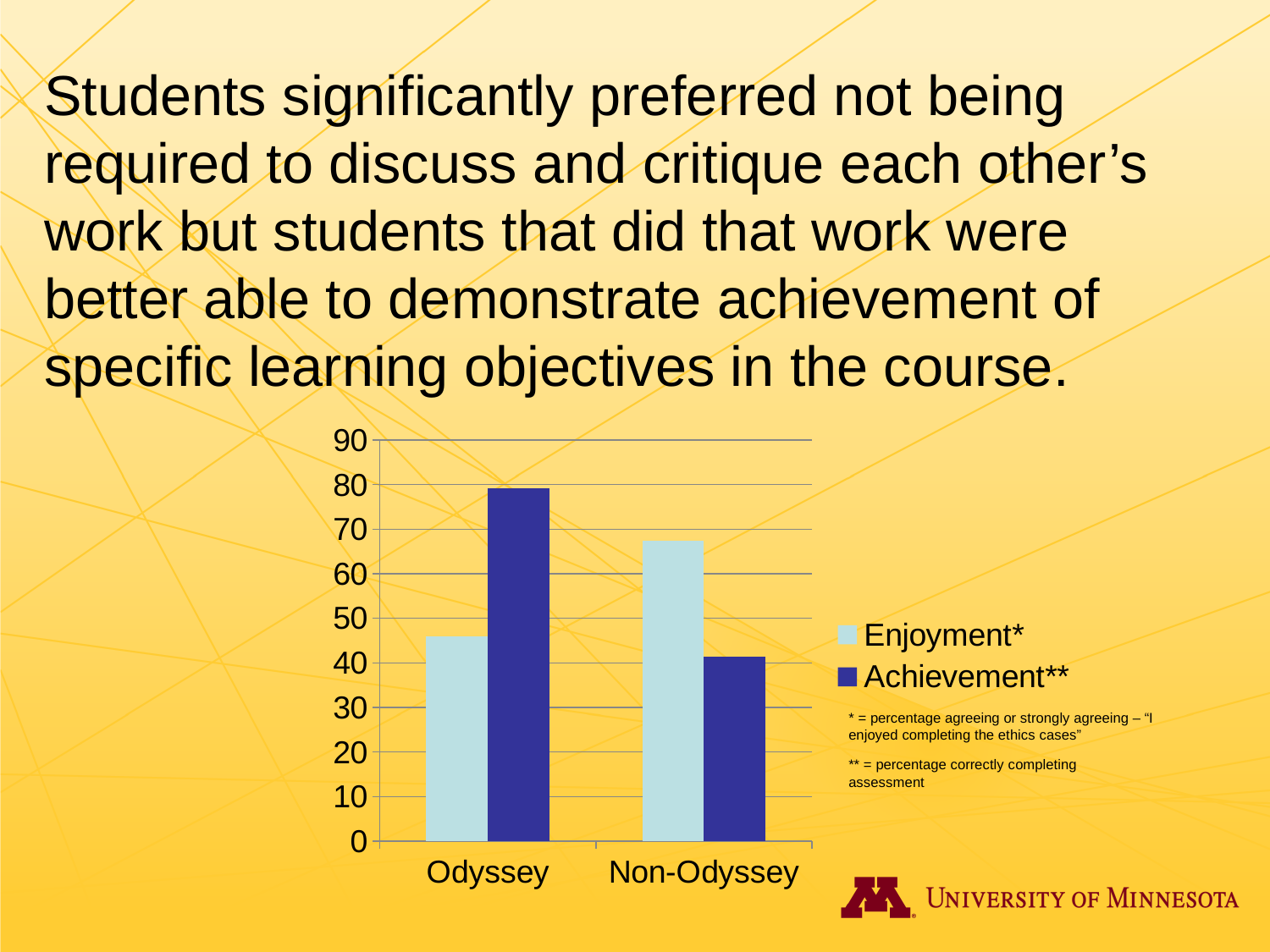
Is the Enjoyment* value for Odyssey greater or less than 50? less For Odyssey, which is larger: Enjoyment* or Achievement**? Achievement** How many categories are shown on the x axis of the chart? 2 Which category has the higher Achievement** value? Odyssey What are the two series named in the chart's legend? Enjoyment* and Achievement** Is the Achievement** value for Non-Odyssey greater or less than 50? less Is the Enjoyment* value for Non-Odyssey greater or less than 60? greater What kind of chart is shown on the slide? bar chart How many series does the chart's legend list? 2 For Non-Odyssey, which is larger: Enjoyment* or Achievement**? Enjoyment* Does the Achievement** value rise or fall from Odyssey to Non-Odyssey? fall